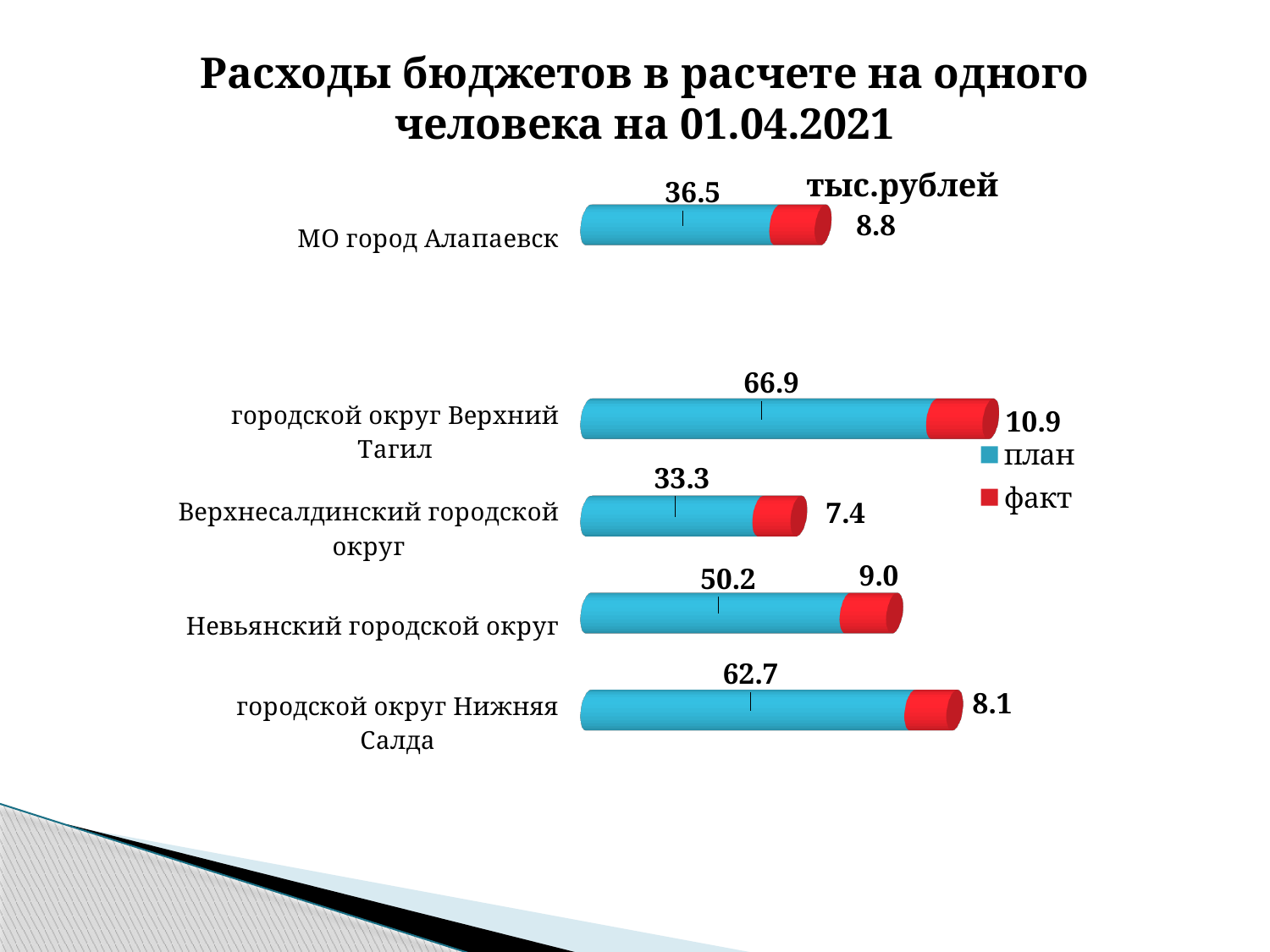
How many categories are shown in the chart? 5 What is the план value for городской округ Верхний Тагил? 66.9 What is the total of the stacked bar for Верхнесалдинский городской округ? 40.7 Which category has the highest план value? городской округ Верхний Тагил Which is larger: the факт value for МО город Алапаевск or for Верхнесалдинский городской округ? МО город Алапаевск How many series does the legend list? 2 What is the план value for МО город Алапаевск? 36.5 What is the факт value for городской округ Нижняя Салда? 8.1 What kind of chart is shown on the slide? bar chart Which category has the lowest факт value? Верхнесалдинский городской округ What is the факт value for Невьянский городской округ? 9.0 What is the difference between the план values for городской округ Нижняя Салда and Невьянский городской округ? 12.5